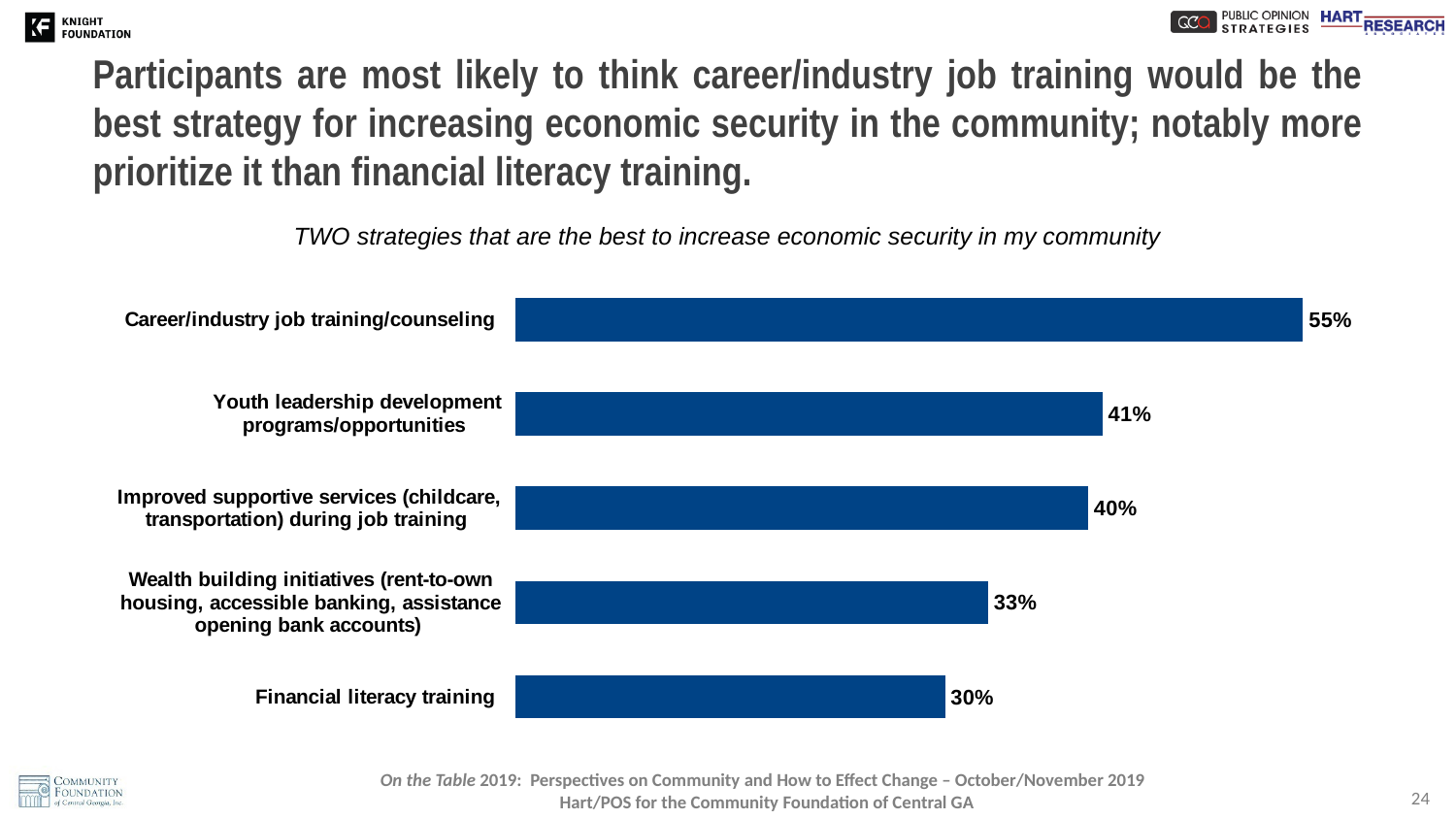
What is the value for improved supportive services (childcare, transportation) during job training? 40% How many strategies are shown on the chart? 5 What type of chart is used on this slide? Bar chart What percentage is shown for wealth building initiatives (rent-to-own housing, accessible banking, assistance opening bank accounts)? 33% What is the difference in percentage points between career/industry job training/counseling and financial literacy training? 25 What is the value shown for financial literacy training? 30% What percentage of participants chose career/industry job training/counseling as one of the best strategies? 55% Which strategy has the lowest percentage on the chart? Financial literacy training What is the subtitle of the chart? TWO strategies that are the best to increase economic security in my community Which has a higher value: youth leadership development programs/opportunities or financial literacy training? Youth leadership development programs/opportunities Which strategy has the highest percentage on the chart? Career/industry job training/counseling What is the difference between youth leadership development programs/opportunities and wealth building initiatives? 8